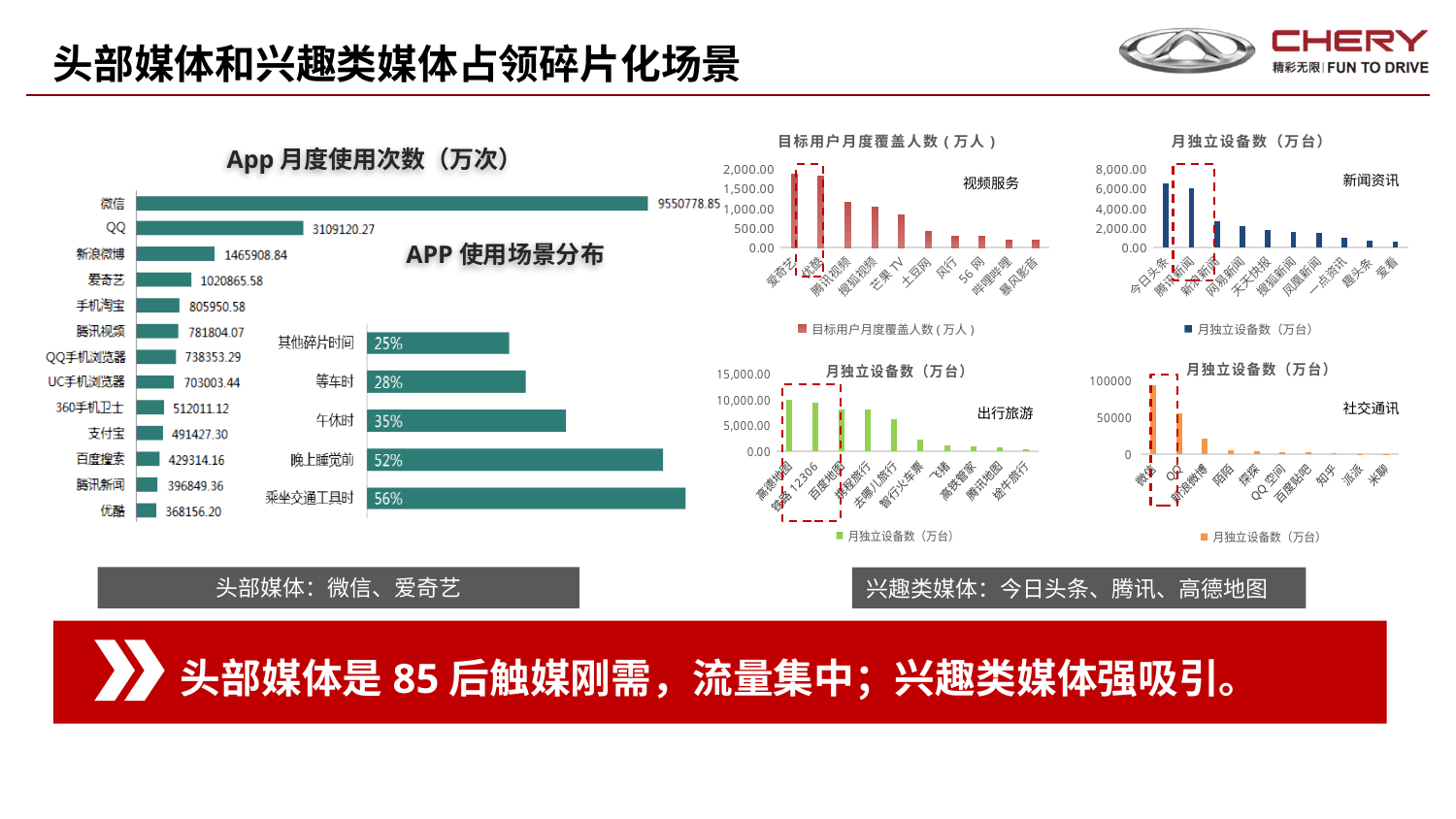
In the 'APP 使用场景分布' chart, which scenario has the highest share? 乘坐交通工具时 In the 'App 月度使用次数（万次）' chart, what is the value for 支付宝? 491427.30 In the '目标用户月度覆盖人数（万人）' chart (视频服务), is the value for 腾讯视频 greater or less than 1,000.00? greater In the 'APP 使用场景分布' chart, what is the value for 晚上睡觉前? 52% In the '月独立设备数（万台）' chart for 出行旅游, which app has the highest value? 高德地图 In the '月独立设备数（万台）' chart for 新闻资讯, is the value for 今日头条 greater or less than 6,000.00? greater In the 'APP 使用场景分布' chart, what is the difference between 午休时 and 等车时? 7% In the 'APP 使用场景分布' chart, how many categories are shown? 5 In the 'App 月度使用次数（万次）' chart, which app has the lowest value? 优酷 In the 'App 月度使用次数（万次）' chart, what is the difference between QQ and 新浪微博? 1643211.43 In the 'App 月度使用次数（万次）' chart, what is the value for 微信? 9550778.85 What type of chart is 'App 月度使用次数（万次）'? Bar chart